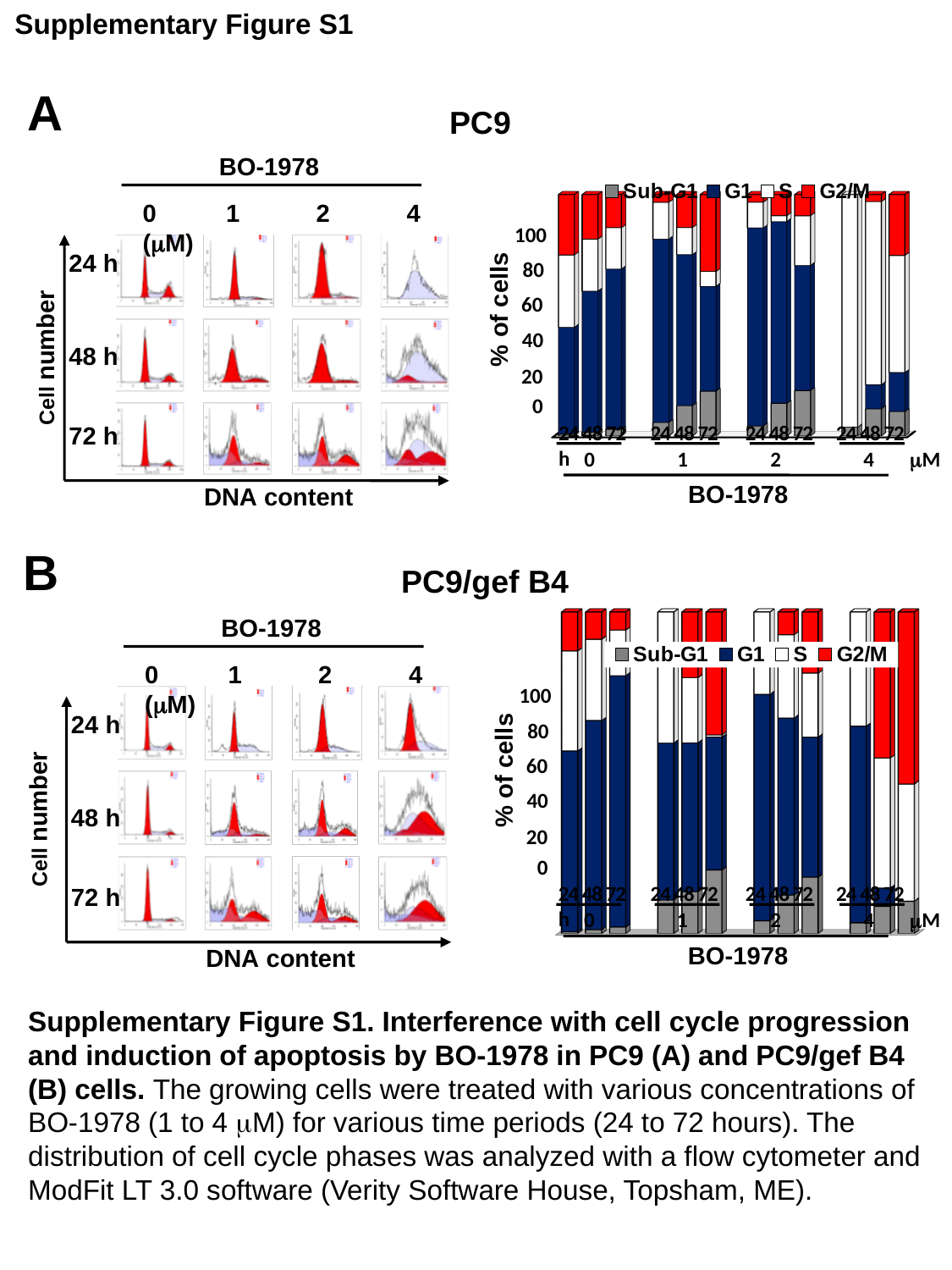
What is the y-axis label of the PC9/gef B4 chart in panel B? % of cells In the PC9 chart in panel A, is the top of the G1 segment for 0 µM at 24 h greater or less than 60? less In the PC9 chart in panel A, which colour represents the G2/M phase? red How many stacked bar charts are on the slide? 2 How many series does the legend of the PC9/gef B4 chart in panel B list? 4 In the PC9 chart in panel A, which BO-1978 concentrations (in µM) are shown on the x axis? 0, 1, 2, 4 Which cell cycle phases are listed in the legend of the PC9 chart in panel A? Sub-G1, G1, S, G2/M What kind of chart is the PC9 chart in panel A? stacked bar chart How many bars are plotted in the PC9 chart in panel A? 12 In the PC9 chart in panel A, is the top of the G1 segment for 1 µM at 24 h greater or less than 80? greater